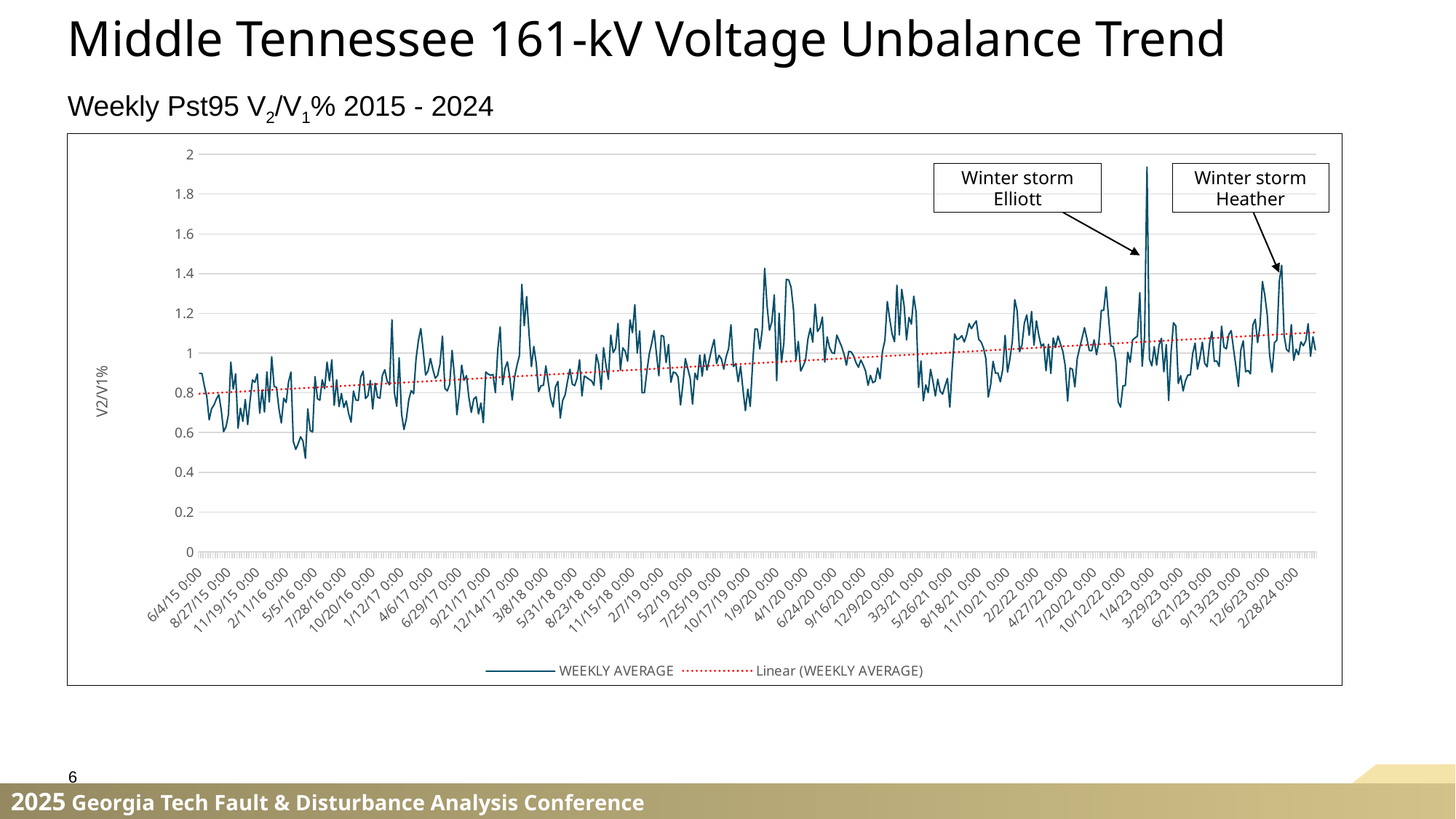
Is the peak value at the Winter storm Elliott annotation greater or less than 1.8? greater What are the two entries in the chart legend? WEEKLY AVERAGE and Linear (WEEKLY AVERAGE) Which annotated winter storm corresponds to the higher peak in the weekly average, Elliott or Heather? Winter storm Elliott Is the highest weekly average value on the chart greater or less than 2? less Is the value of the linear trend line at the right edge of the chart (2/28/24) greater or less than 1? greater Does the linear trend line rise or fall from left to right across the chart? rise What kind of chart is shown on the slide? line chart What is the label on the vertical axis of the chart? V2/V1% How many series does the chart legend list? 2